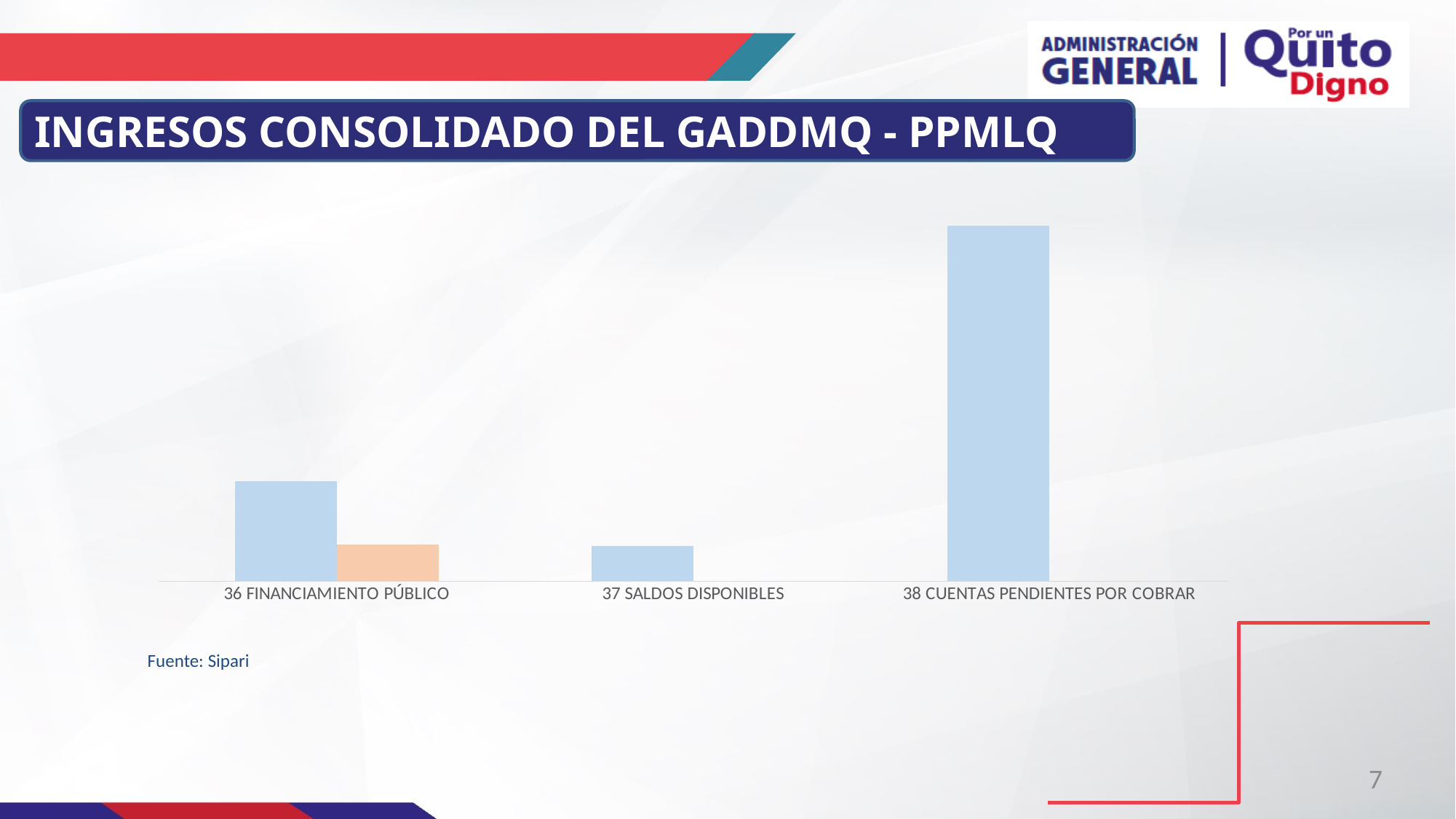
What kind of chart is shown on the slide? bar chart What is the title shown above the chart on the slide? INGRESOS CONSOLIDADO DEL GADDMQ - PPMLQ How many categories are shown on the x axis of the chart? 3 Which category has the tallest bar in the chart? 38 CUENTAS PENDIENTES POR COBRAR Which is larger, the blue bar for 36 FINANCIAMIENTO PÚBLICO or the blue bar for 37 SALDOS DISPONIBLES? 36 FINANCIAMIENTO PÚBLICO Within the category 36 FINANCIAMIENTO PÚBLICO, which bar is taller, the blue one or the orange one? the blue one Which category has the shortest blue bar in the chart? 37 SALDOS DISPONIBLES Which is larger, the blue bar for 38 CUENTAS PENDIENTES POR COBRAR or the blue bar for 36 FINANCIAMIENTO PÚBLICO? 38 CUENTAS PENDIENTES POR COBRAR Which category is the only one that shows an orange bar in addition to a blue bar? 36 FINANCIAMIENTO PÚBLICO